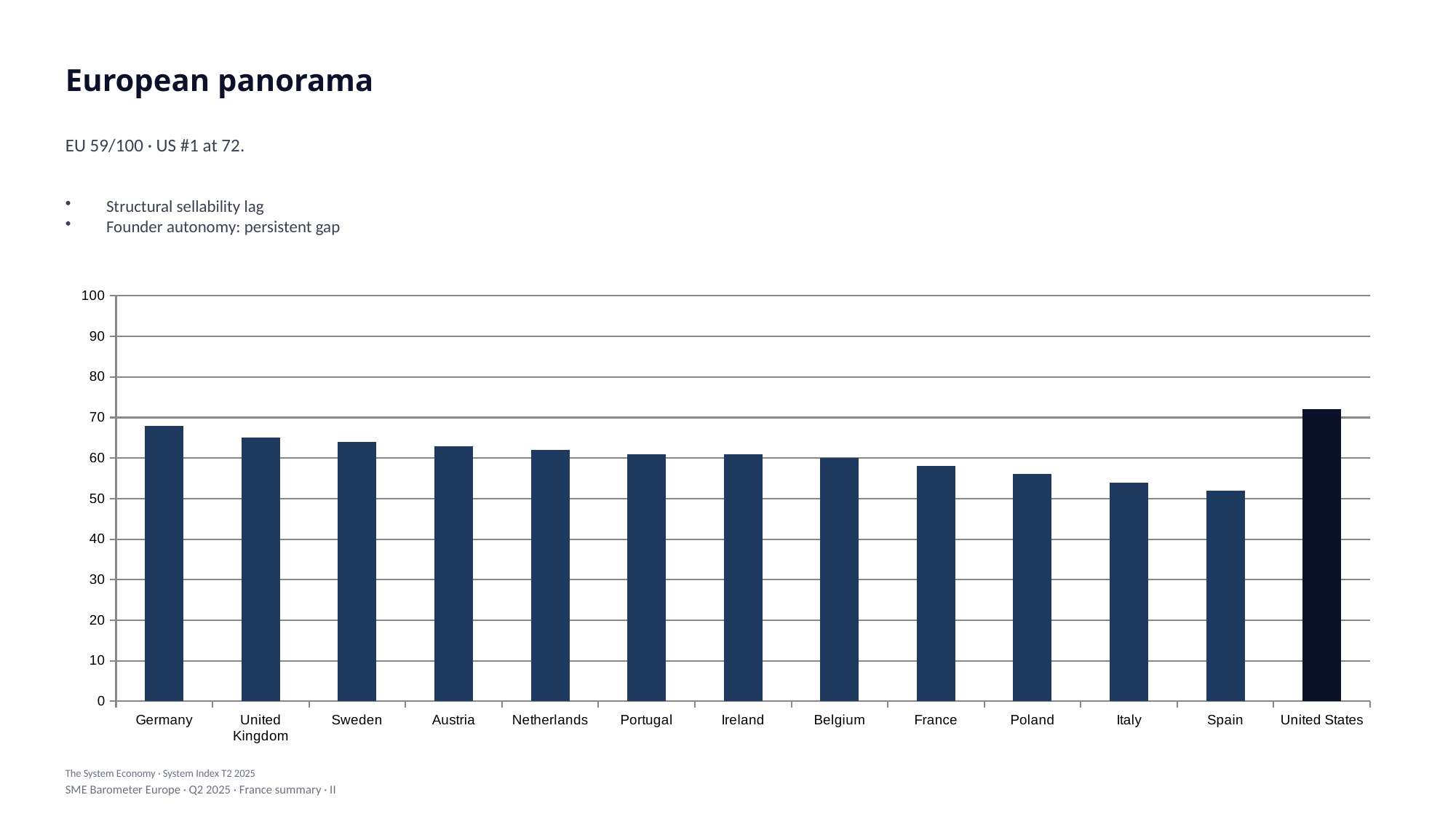
Is the value for United States greater or less than 70? greater Is the value for Spain greater or less than 60? less Which country has the highest bar in the chart? United States Do the values rise or fall along the x axis from Germany to Spain? fall Which has the larger value, United States or Germany? United States Which has the larger value, Germany or Spain? Germany How many countries are plotted in the chart? 13 Is the value for Germany greater or less than 60? greater Which bar in the chart is shown in a darker colour than the others? United States Which country has the lowest bar in the chart? Spain What is the value for United States, as stated on the slide? 72 What kind of chart is shown on the slide? bar chart